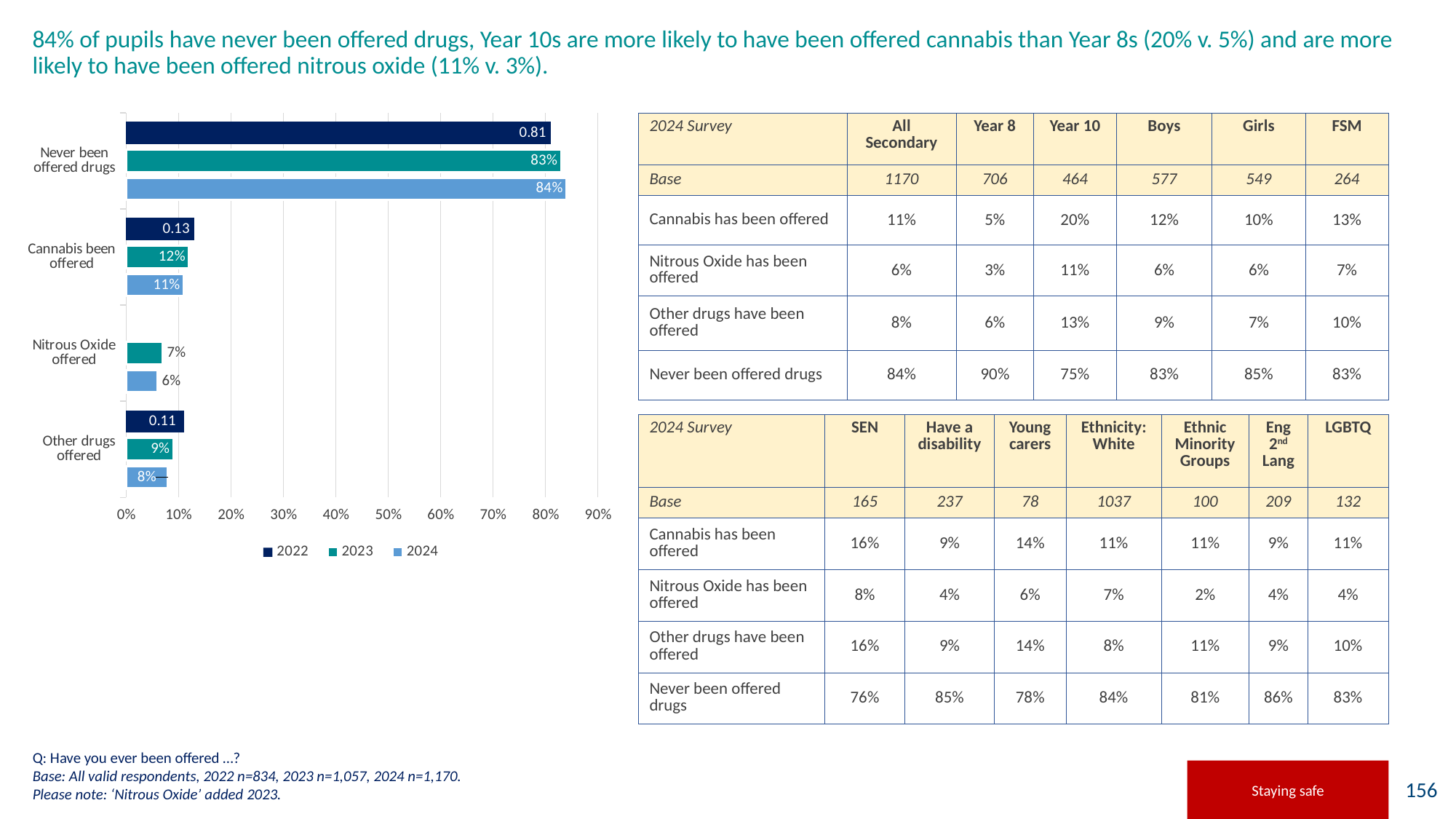
What is the 2023 value for 'Cannabis been offered' in the chart? 12% How many series does the chart legend list? 3 How many categories are shown on the chart? 4 Which category has the lowest 2023 value in the chart? Nitrous Oxide offered What is the 2024 value for 'Nitrous Oxide offered' in the chart? 6% Which category has the highest 2024 value in the chart? Never been offered drugs What kind of chart is shown on the slide? bar chart What is the 2022 value for 'Other drugs offered' in the chart? 0.11 What is the difference between the 2023 and 2024 values for 'Other drugs offered' in the chart? 1% What is the 2022 value for 'Never been offered drugs' in the chart? 0.81 What is the 2024 value for 'Never been offered drugs' in the chart? 84% Which series is shown in the darkest blue colour in the chart? 2022